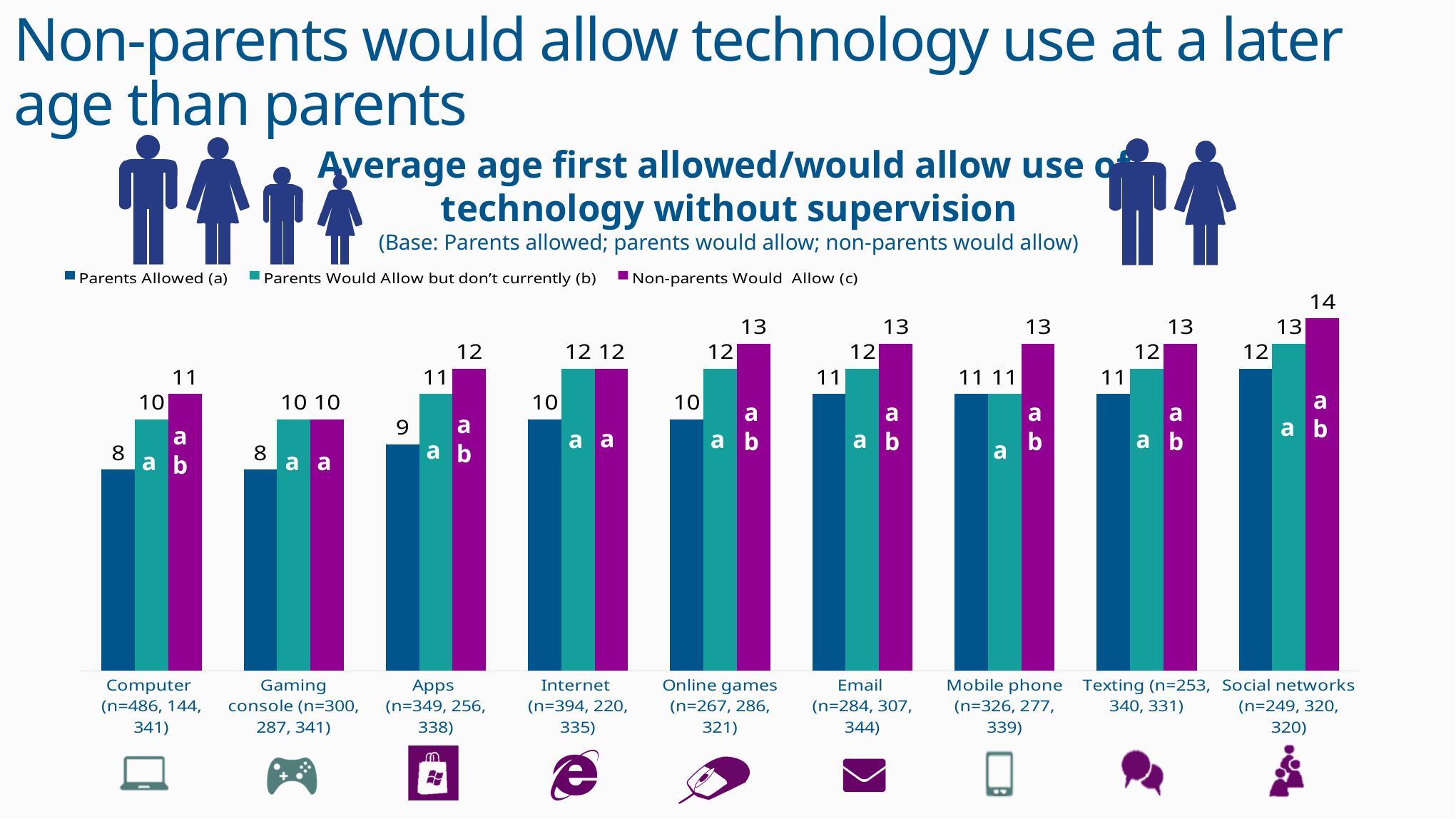
What is the Parents Allowed value for Computer? 8 What is the Non-parents Would Allow value for Social networks? 14 What is the difference between the Non-parents Would Allow value and the Parents Allowed value for Computer? 3 How many series does the legend list? 3 Which category has the lowest Parents Would Allow but don't currently value? Computer and Gaming console What is the Non-parents Would Allow value for Mobile phone? 13 Which category has the highest Non-parents Would Allow value? Social networks Which is larger for Apps: the Parents Allowed value or the Non-parents Would Allow value? Non-parents Would Allow What is the Parents Would Allow but don't currently value for Apps? 11 What kind of chart is shown on the slide? Bar chart How many technology categories are shown on the x axis? 9 Does the Parents Allowed series generally rise or fall from Computer to Social networks? Rise